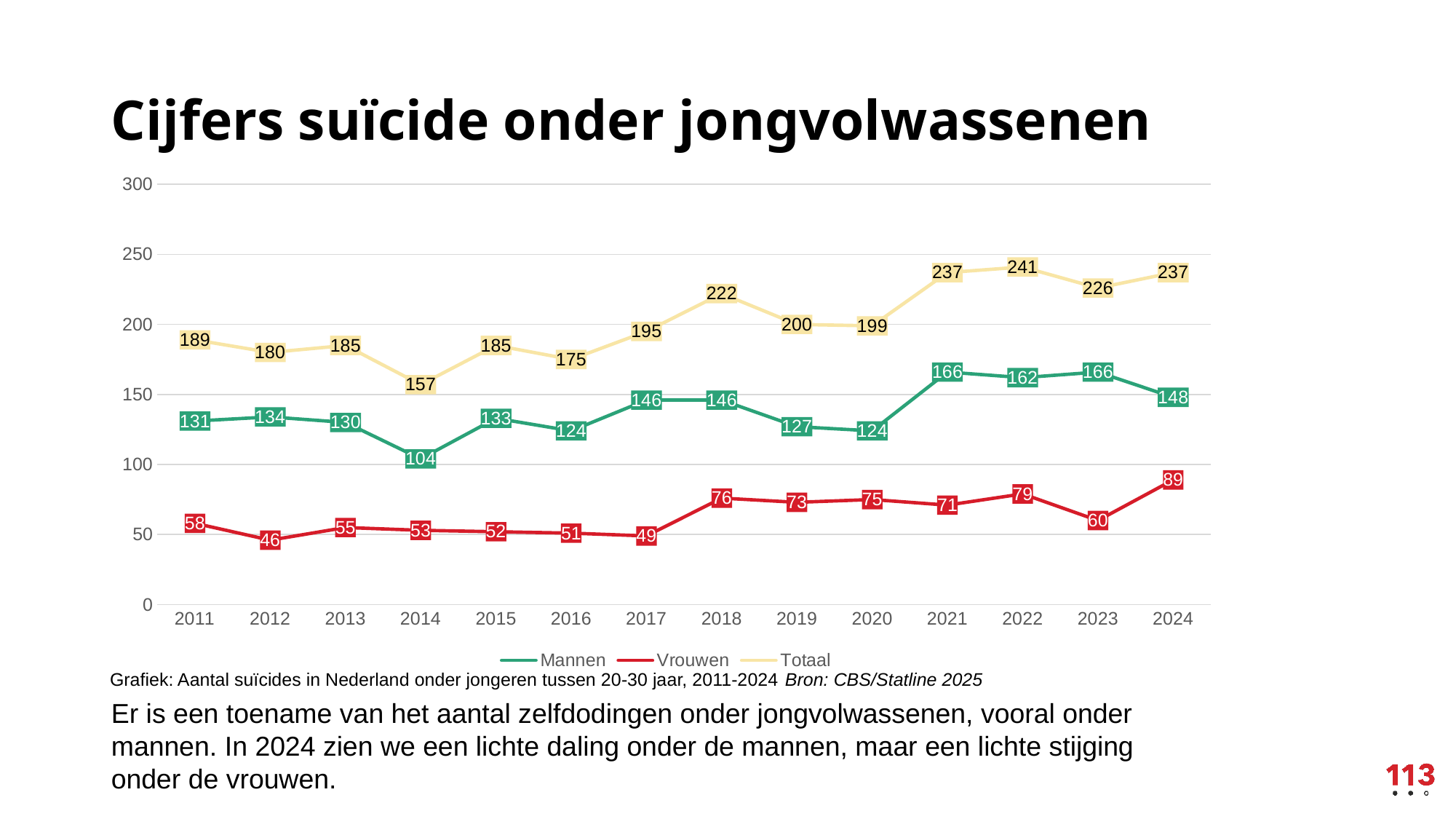
In which year is the Totaal series highest? 2022 What is the difference between the Totaal values for 2022 and 2023? 15 What is the value for Mannen in 2014? 104 In which year is the Vrouwen series lowest? 2012 Which is larger: the Mannen value in 2021 or in 2024? 2021 How many series does the legend list? 3 What is the value for Totaal in 2018? 222 Does the Vrouwen series rise or fall from 2023 to 2024? rise How many years are shown on the x axis? 14 Which series is drawn in red? Vrouwen What is the value for Vrouwen in 2024? 89 What kind of chart is shown on the slide? line chart